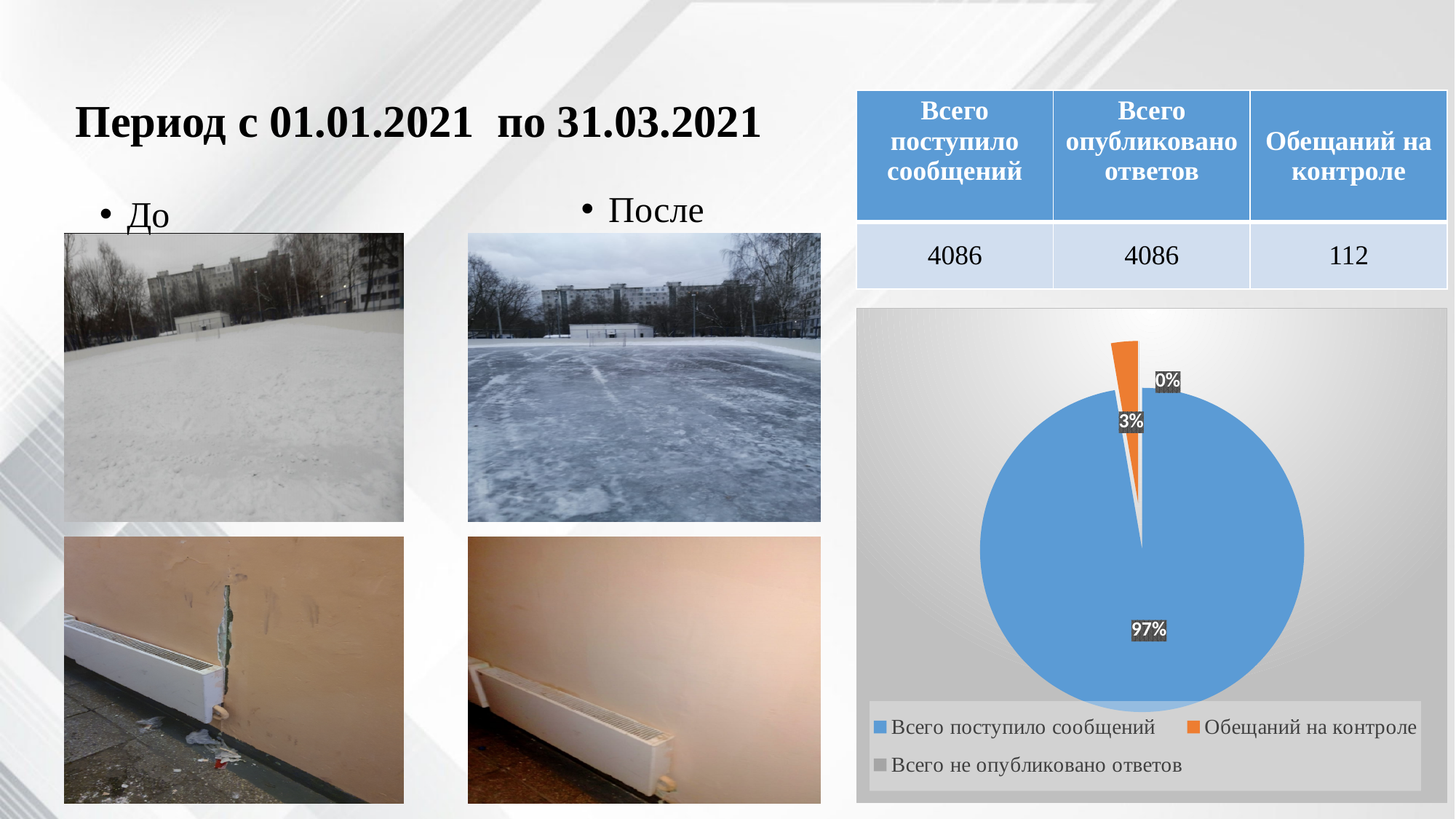
What percentage does the pie chart show for "Обещаний на контроле"? 3% What percentage does the pie chart show for "Всего не опубликовано ответов"? 0% What colour is the slice for "Обещаний на контроле" in the pie chart? orange In the pie chart, which is larger: the slice for "Всего поступило сообщений" or the slice for "Обещаний на контроле"? Всего поступило сообщений What colour is the slice for "Всего поступило сообщений" in the pie chart? blue How many slices are labelled in the pie chart? 3 What percentage does the pie chart show for "Всего поступило сообщений"? 97% Which category has the smallest slice in the pie chart? Всего не опубликовано ответов What kind of chart is shown on the right side of the slide? pie chart How many entries does the legend of the pie chart list? 3 Which category has the largest slice in the pie chart? Всего поступило сообщений What is the difference in percentage points between the "Всего поступило сообщений" slice and the "Обещаний на контроле" slice in the pie chart? 94